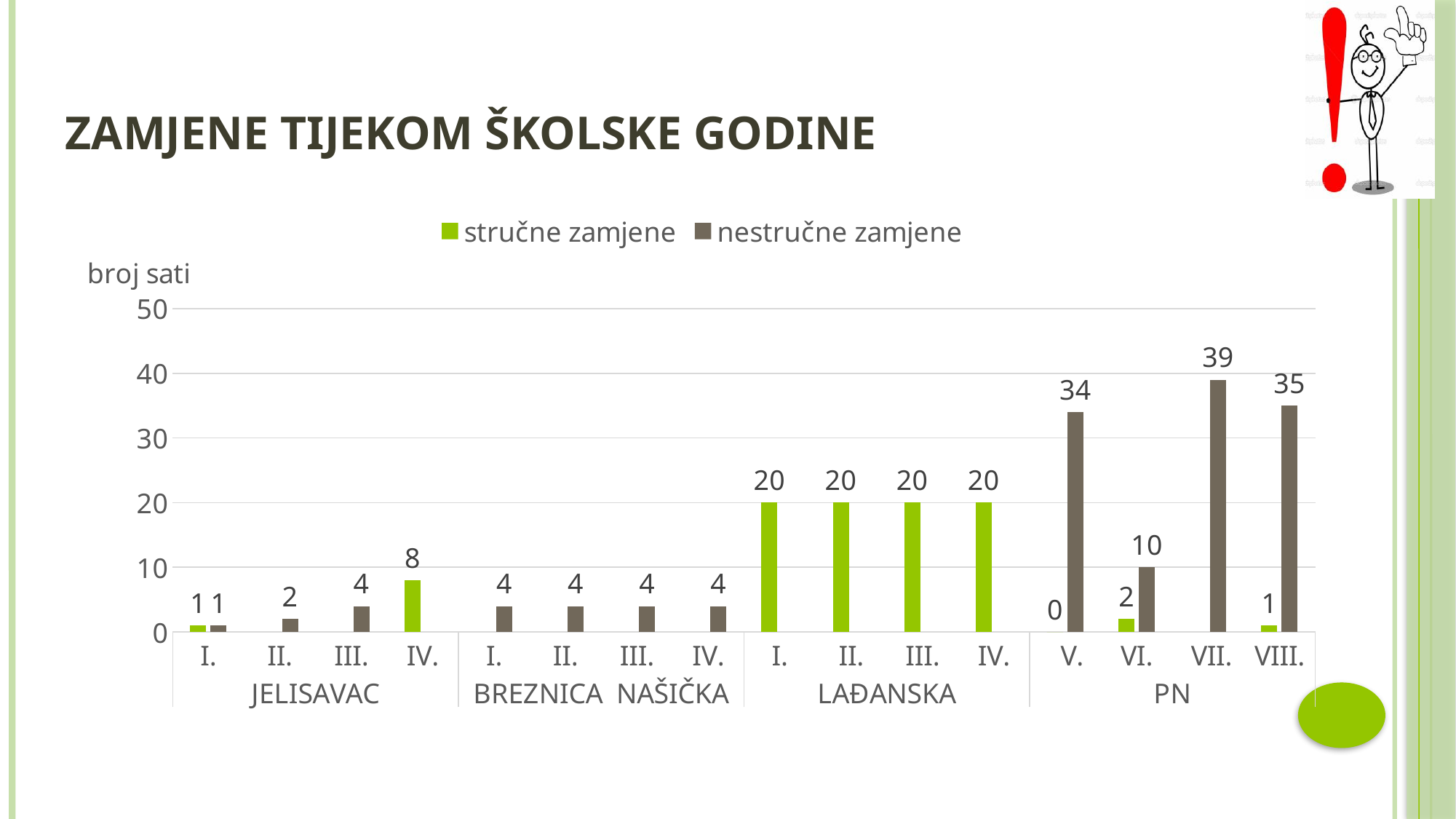
How many school groups are shown along the x axis? 4 How many series does the legend list? 2 What is the label of the vertical axis? broj sati Which class has the highest value of nestručne zamjene? VII. (PN) What is the value of stručne zamjene for class IV. in the JELISAVAC group? 8 What is the difference between nestručne zamjene for VII. and VIII. in the PN group? 4 Which is larger: stručne zamjene for IV. in JELISAVAC or stručne zamjene for I. in LAĐANSKA? I. in LAĐANSKA What kind of chart is shown on the slide? bar chart What is the value of nestručne zamjene for class VI. in the PN group? 10 What is the value of nestručne zamjene for class VII. in the PN group? 39 What is the total of stručne zamjene and nestručne zamjene for class VI. in the PN group? 12 What is the value of stručne zamjene for class V. in the PN group? 0